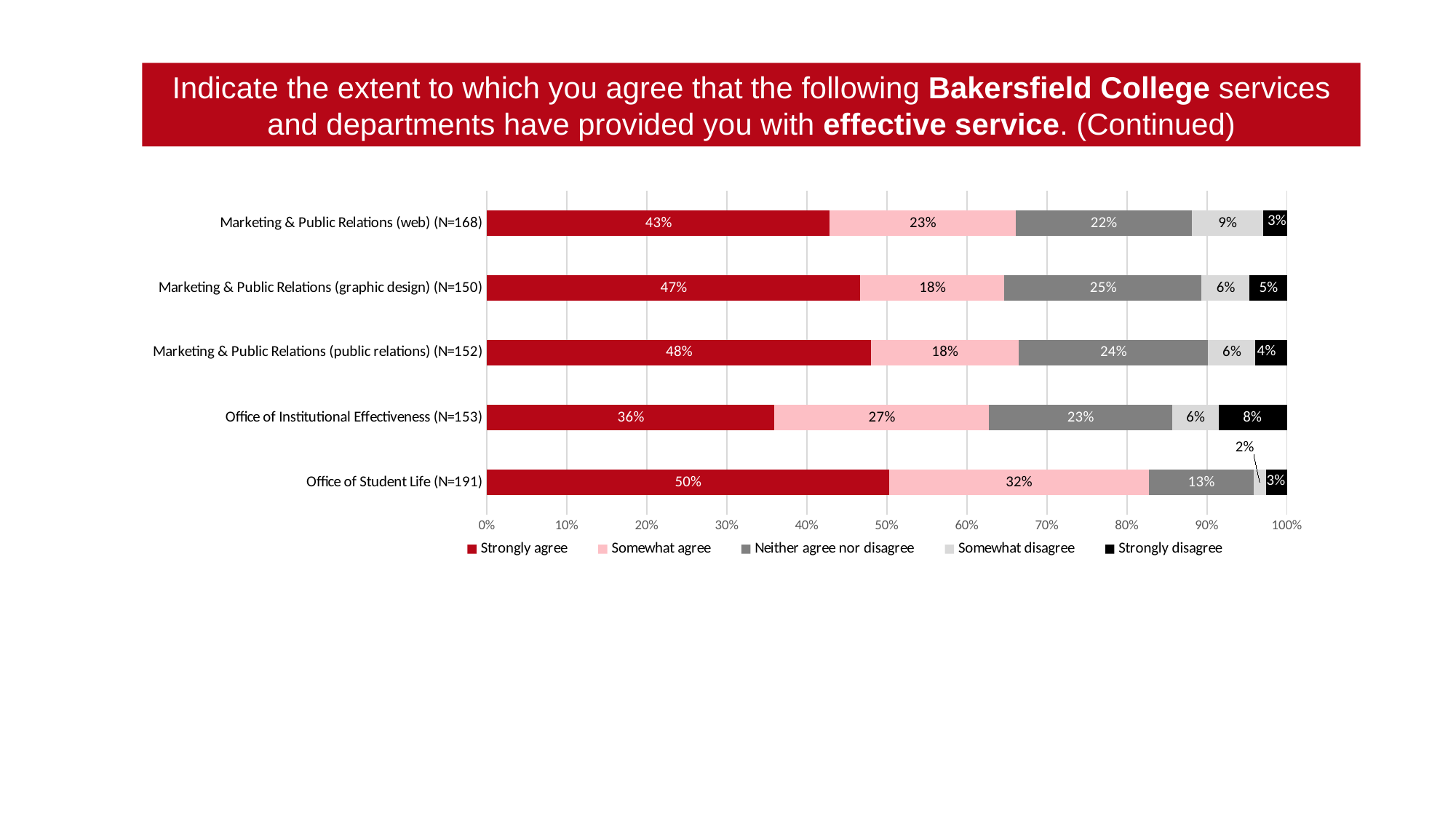
What percentage of respondents strongly agree that the Office of Student Life (N=191) provided effective service? 50% How many series does the legend list? 5 What is the difference between the 'Somewhat agree' values for the Office of Student Life (N=191) and Marketing & Public Relations (web) (N=168)? 9% What kind of chart is shown on the slide? Stacked bar chart Which category has the highest 'Strongly agree' percentage? Office of Student Life (N=191) Which category has the lowest 'Strongly agree' percentage? Office of Institutional Effectiveness (N=153) What is the 'Strongly disagree' value for the Office of Institutional Effectiveness (N=153)? 8% How many categories (services/departments) are shown on the chart? 5 What is the 'Somewhat disagree' value for Marketing & Public Relations (web) (N=168)? 9% Which has a larger 'Neither agree nor disagree' value: Marketing & Public Relations (public relations) (N=152) or Office of Student Life (N=191)? Marketing & Public Relations (public relations) (N=152) Which legend entry is shown in black? Strongly disagree What is the 'Neither agree nor disagree' value for Marketing & Public Relations (graphic design) (N=150)? 25%